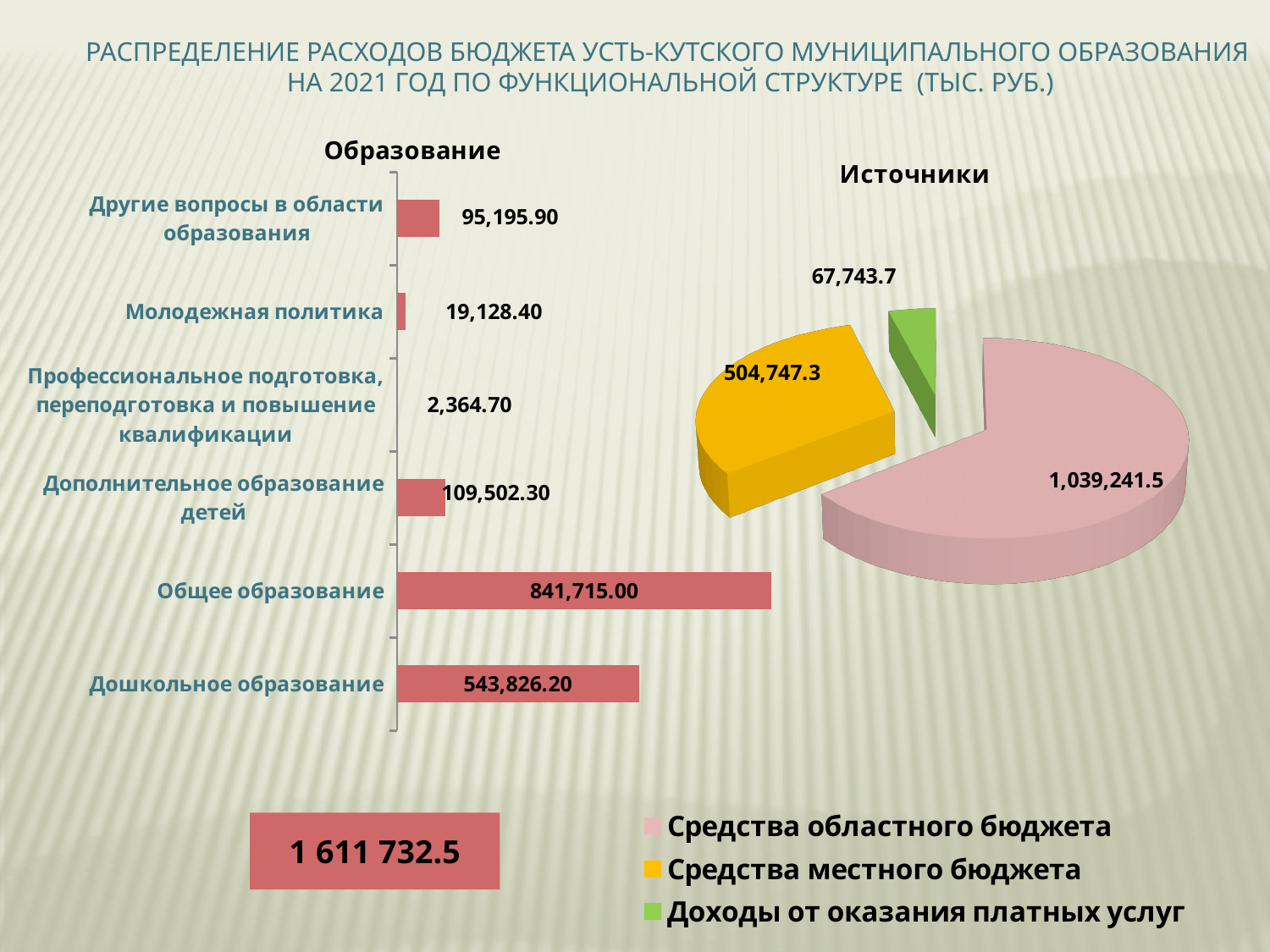
In the bar chart "Образование", which is larger: "Дополнительное образование детей" or "Другие вопросы в области образования"? Дополнительное образование детей In the bar chart "Образование", which category has the highest value? Общее образование How many categories are shown in the bar chart "Образование"? 6 In the pie chart "Источники", which source has the largest slice? Средства областного бюджета In the pie chart "Источники", what is the difference between "Средства областного бюджета" and "Средства местного бюджета"? 534,494.2 In the bar chart "Образование", what is the value for "Общее образование"? 841,715.00 How many entries does the legend of the pie chart "Источники" list? 3 In the bar chart "Образование", what is the difference between "Общее образование" and "Дошкольное образование"? 297,888.80 In the bar chart "Образование", what is the value for "Молодежная политика"? 19,128.40 What type of chart is the "Образование" chart? Bar chart In the pie chart "Источники", what is the value for "Средства местного бюджета"? 504,747.3 In the bar chart "Образование", which category has the lowest value? Профессиональное подготовка, переподготовка и повышение квалификации